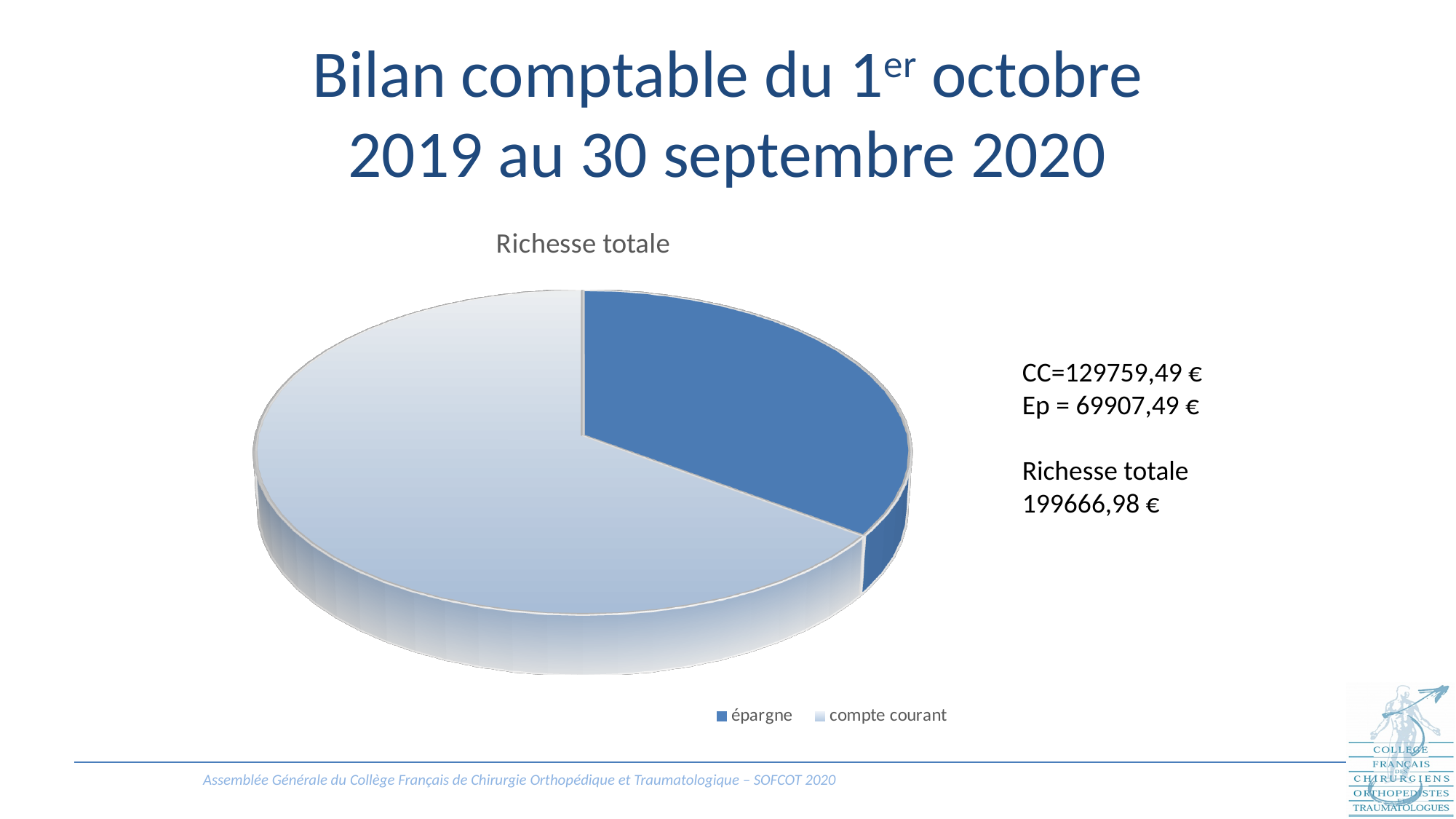
Which category has the largest slice of the pie? compte courant What is the total richesse totale shown on the slide? 199666,98 € What kind of chart is shown on the slide? pie chart What is the value of the épargne (Ep) according to the slide? 69907,49 € Which colour represents épargne in the pie chart? dark blue How many slices does the pie chart have? 2 What is the value of the compte courant (CC) according to the slide? 129759,49 € Which is larger, the épargne slice or the compte courant slice? compte courant What is the title of the chart? Richesse totale Which category has the smallest slice of the pie? épargne How many entries does the chart legend list? 2 By how much does the compte courant exceed the épargne? 59852,00 €